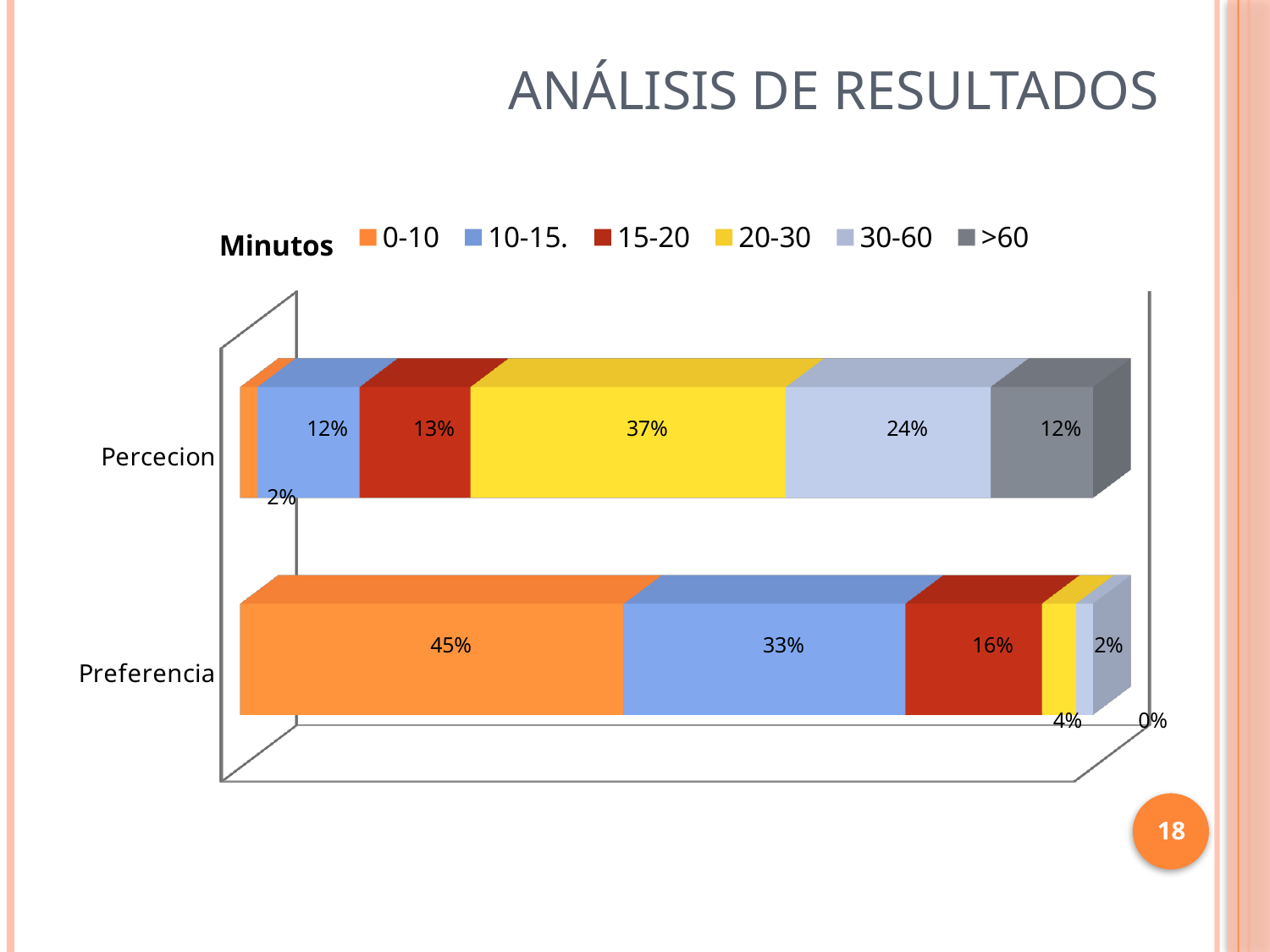
What is the value of the 20-30 series for Percecion? 37% Which series has the largest value for Percecion? 20-30 How many series does the legend list? 6 What is the value of the 15-20 series for Preferencia? 16% Which is larger: the 10-15. value for Preferencia or the 10-15. value for Percecion? Preferencia What is the legend title of the chart? Minutos Which series has the smallest value for Preferencia? >60 What is the difference between the 0-10 value for Preferencia and the 0-10 value for Percecion? 43% What kind of chart is shown on the slide? Stacked bar chart How many categories are plotted on the chart? 2 What is the value of the 0-10 series for Preferencia? 45% What is the value of the 30-60 series for Percecion? 24%